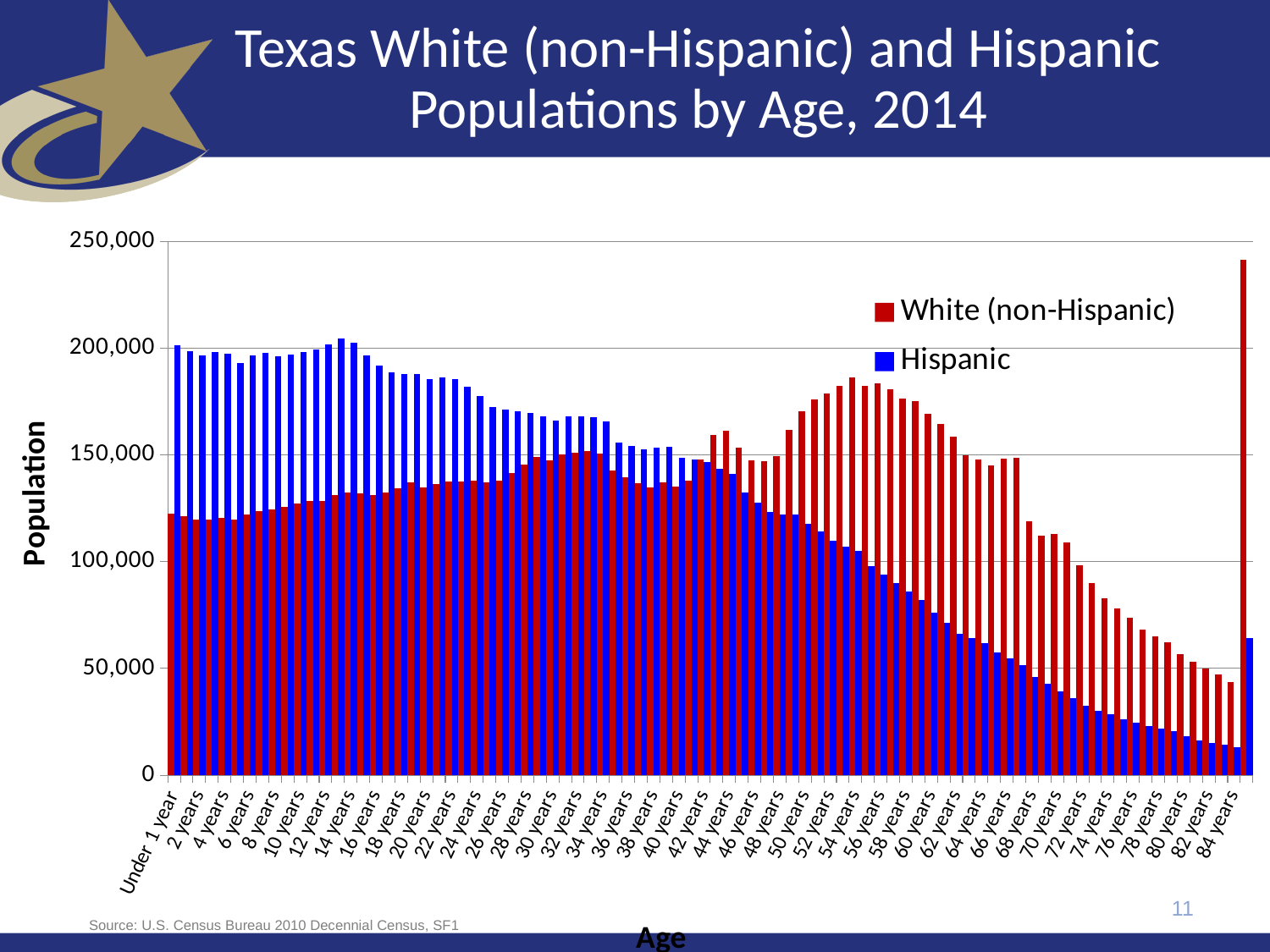
What kind of chart is shown on the slide? bar chart Is the White (non-Hispanic) value for 54 years greater or less than 150,000? greater How many series does the legend list? 2 Which colour represents the Hispanic series in the chart? blue What is the label of the vertical axis? Population At 2 years, which series has the larger value, White (non-Hispanic) or Hispanic? Hispanic Do the Hispanic values rise or fall from 14 years to 84 years? fall Is the White (non-Hispanic) value for Under 1 year greater or less than 100,000? greater At 54 years, which series has the larger value, White (non-Hispanic) or Hispanic? White (non-Hispanic) Is the Hispanic value for 60 years greater or less than 100,000? less